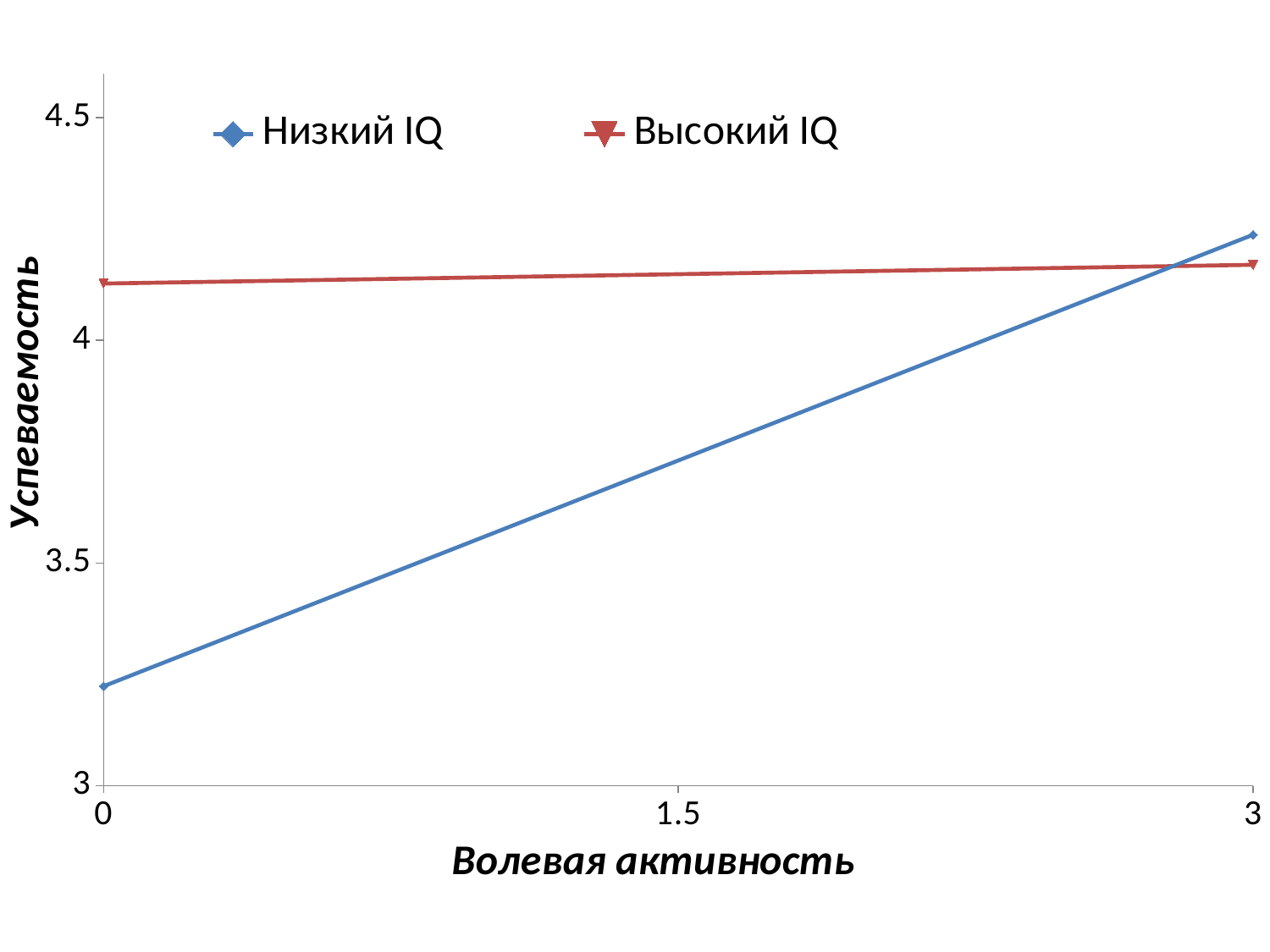
Is the value for Высокий IQ at Волевая активность 3 greater or less than 4.5? less Is the value for Высокий IQ at Волевая активность 0 greater or less than 4? greater At Волевая активность 0, which series has the higher value, Низкий IQ or Высокий IQ? Высокий IQ What is the title of the x axis? Волевая активность What kind of chart is shown on the slide? line chart Which series has the lowest value anywhere on the chart? Низкий IQ Does the value for Низкий IQ rise or fall as Волевая активность increases from 0 to 3? rise Is the value for Низкий IQ at Волевая активность 0 greater or less than 3.5? less What are the two series named in the legend? Низкий IQ and Высокий IQ How many series does the legend list? 2 How many tick labels are shown on the x axis? 3